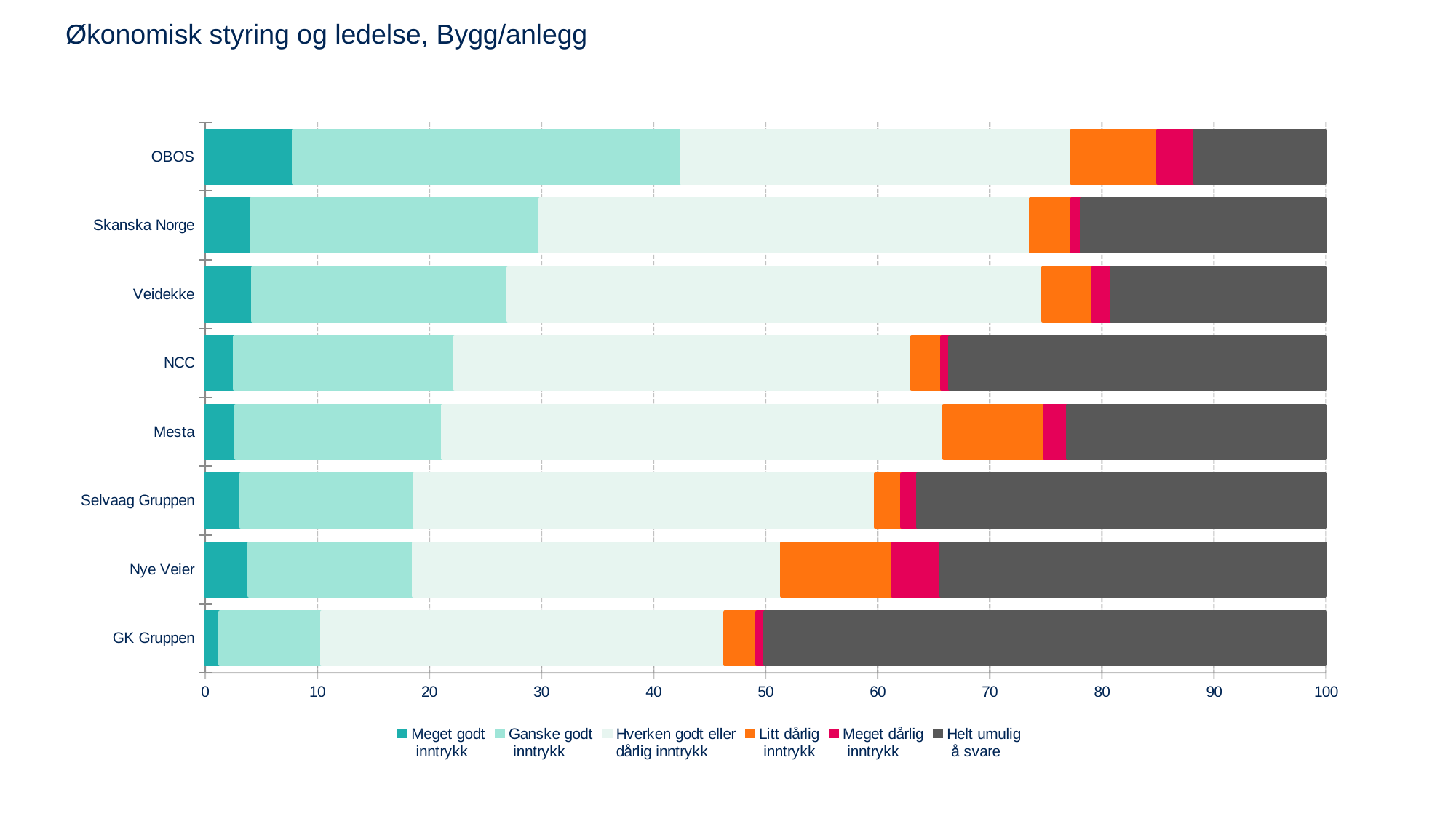
Which company has the largest 'Meget godt inntrykk' segment? OBOS Which company has the largest 'Helt umulig å svare' segment? GK Gruppen How many companies are listed on the vertical axis of the chart? 8 Which company has the smallest 'Helt umulig å svare' segment? OBOS Which is larger: the 'Meget godt inntrykk' segment for OBOS or for Skanska Norge? OBOS What kind of chart is shown on the slide? Stacked bar chart What is the title of the chart? Økonomisk styring og ledelse, Bygg/anlegg What is the total of the stacked bar for OBOS? 100 Which legend entry is shown in dark grey? Helt umulig å svare Is the 'Helt umulig å svare' value for Nye Veier greater or less than 30? greater How many series does the legend list? 6 Is the 'Meget godt inntrykk' value for OBOS greater or less than 10? less